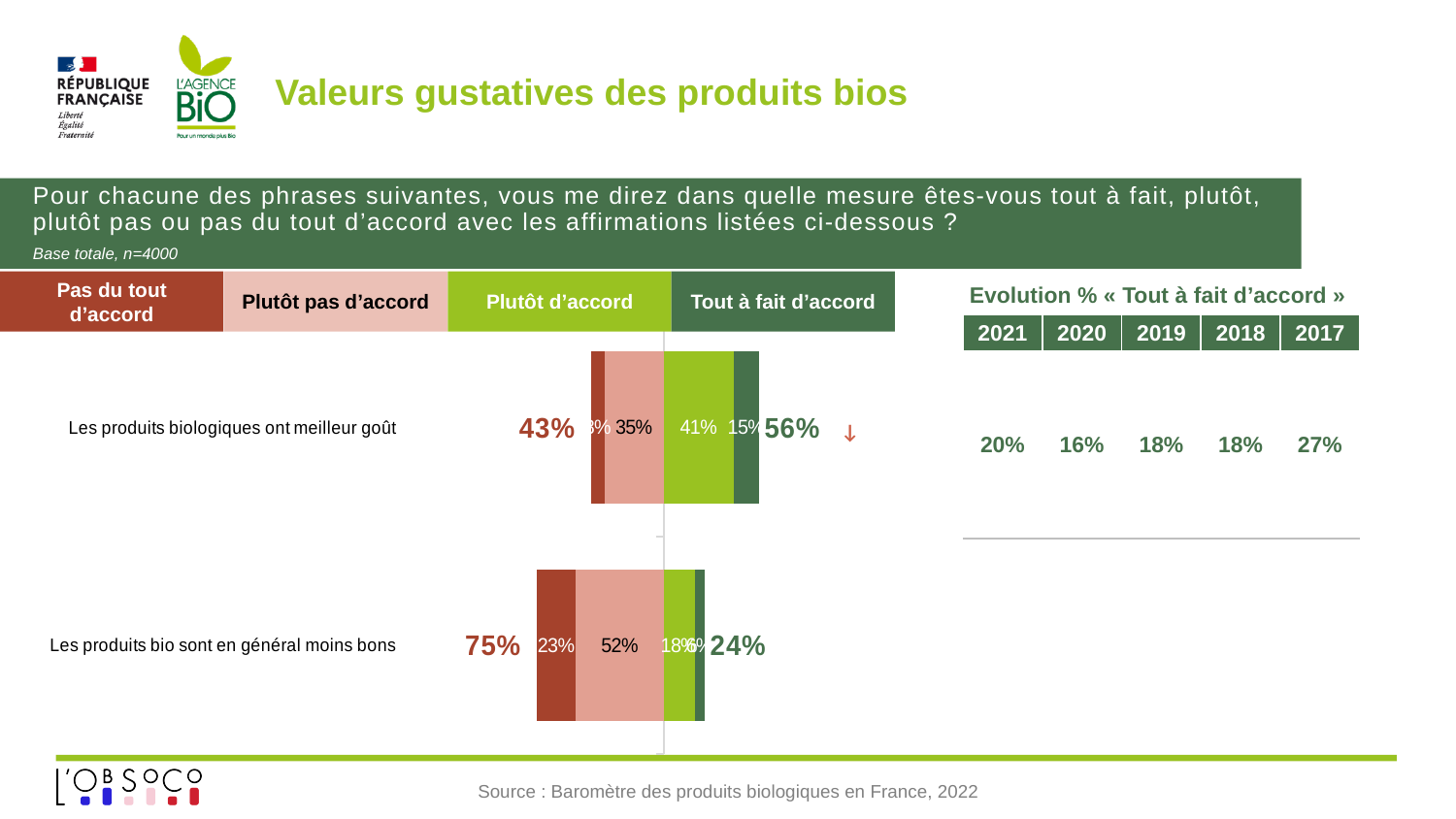
What kind of chart is used to show the responses to the two statements? Stacked bar chart How many response categories does the legend above the bars list? 4 In the 'Evolution % « Tout à fait d'accord »' table, which year has the highest value? 2017 What percentage of respondents answered 'Plutôt pas d'accord' to 'Les produits bio sont en général moins bons'? 52% What is the combined agreement share (Plutôt d'accord + Tout à fait d'accord) for 'Les produits biologiques ont meilleur goût'? 56% What percentage answered 'Plutôt d'accord' to 'Les produits biologiques ont meilleur goût'? 41% Which statement has the higher total agreement share: 'Les produits biologiques ont meilleur goût' or 'Les produits bio sont en général moins bons'? Les produits biologiques ont meilleur goût What percentage of respondents are 'Tout à fait d'accord' that organic products taste better (Les produits biologiques ont meilleur goût)? 15% What is the difference between the total agreement shares of the two statements (56% vs 24%)? 32 percentage points In the 'Evolution % « Tout à fait d'accord »' table, what is the value for 2020? 16% What is the combined disagreement share for 'Les produits bio sont en général moins bons'? 75% What percentage answered 'Pas du tout d'accord' to 'Les produits bio sont en général moins bons'? 23%